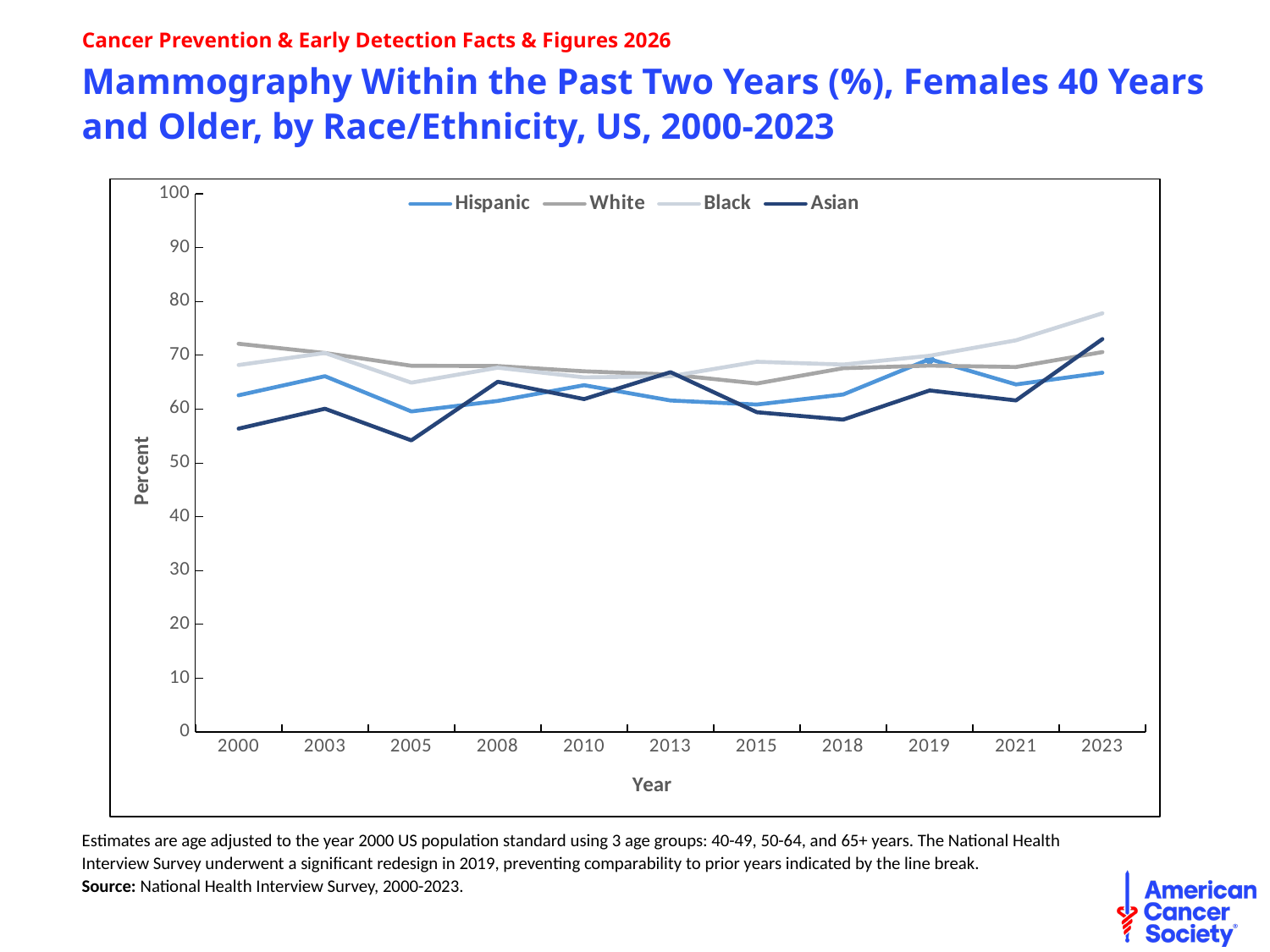
Is the value for Asian in 2005 greater or less than 60? less Does the Black line rise or fall from 2015 to 2023? Rise What is the label on the y axis? Percent How many series does the legend list? 4 Is the value for White in 2000 greater or less than 70? greater In 2000, which is larger, the value for White or the value for Asian? White Which race/ethnicity group has the highest value in 2023? Black How many years are plotted along the x axis? 11 Which race/ethnicity group has the lowest value in 2005? Asian In 2019, which is larger, the value for Hispanic or the value for Asian? Hispanic What kind of chart is shown on the slide? Line chart Is the value for Black in 2023 greater or less than 70? greater